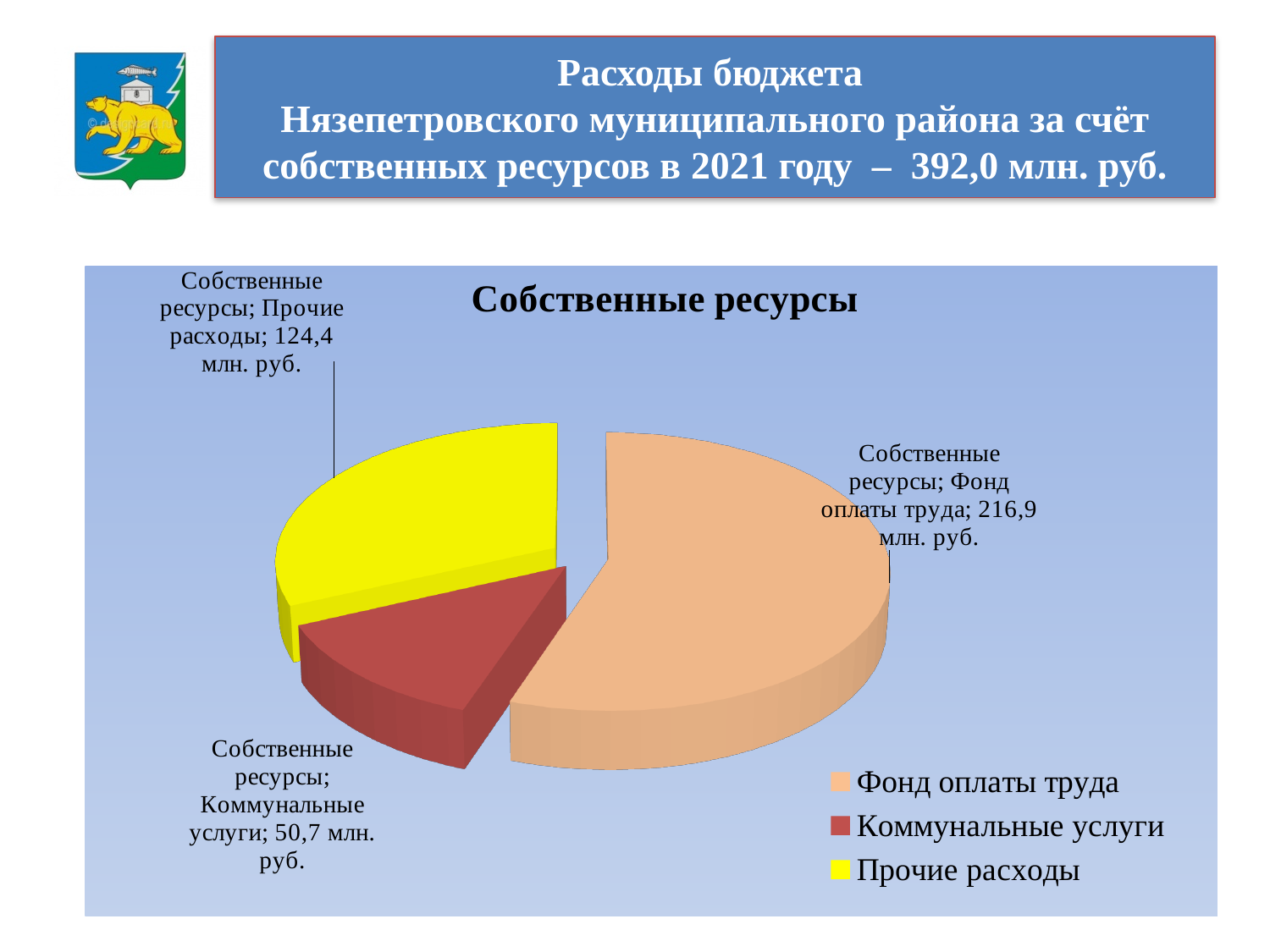
Which colour represents Прочие расходы in the legend? Yellow What is the title of the pie chart? Собственные ресурсы Which category has the smallest slice in the pie chart? Коммунальные услуги Which is larger, Прочие расходы or Коммунальные услуги? Прочие расходы What is the difference between Прочие расходы and Коммунальные услуги? 73,7 млн. руб. What is the value for Прочие расходы in the pie chart? 124,4 млн. руб. What is the difference between Фонд оплаты труда and Коммунальные услуги? 166,2 млн. руб. What is the value for Коммунальные услуги in the pie chart? 50,7 млн. руб. What is the value for Фонд оплаты труда in the pie chart? 216,9 млн. руб. What type of chart is shown on the slide? Pie chart How many categories does the pie chart have? 3 Which category has the largest slice in the pie chart? Фонд оплаты труда